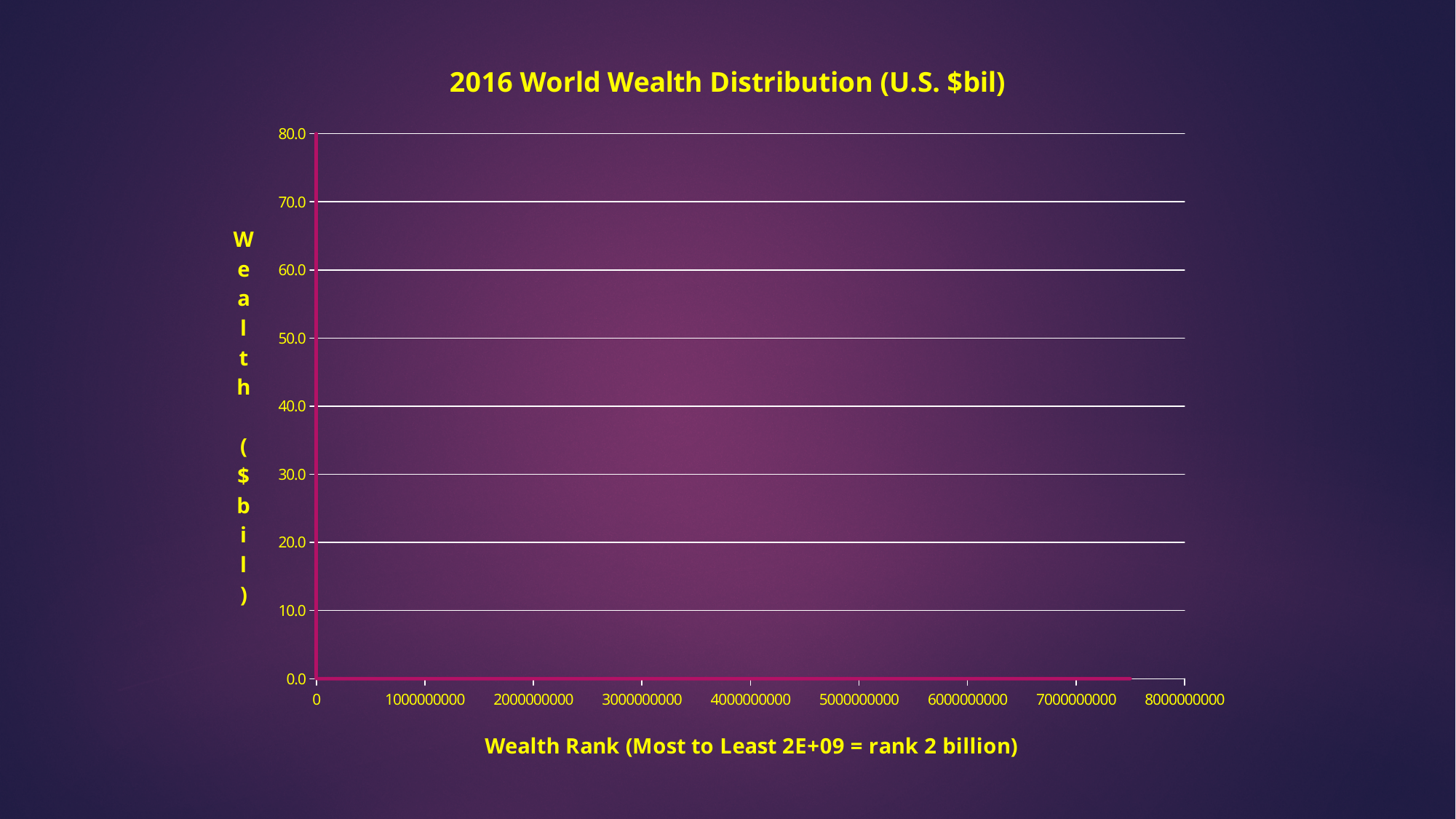
What is the title of the chart? 2016 World Wealth Distribution (U.S. $bil) Is the plotted wealth value at rank 4000000000 greater or less than 10.0? less What kind of chart is shown on the slide? line chart Is the highest plotted wealth value, at the far left of the chart, greater or less than 70.0? greater What is the label of the x axis? Wealth Rank (Most to Least 2E+09 = rank 2 billion) Do the plotted wealth values rise or fall as wealth rank increases along the x axis? fall Is the plotted wealth value at rank 1000000000 greater or less than 20.0? less